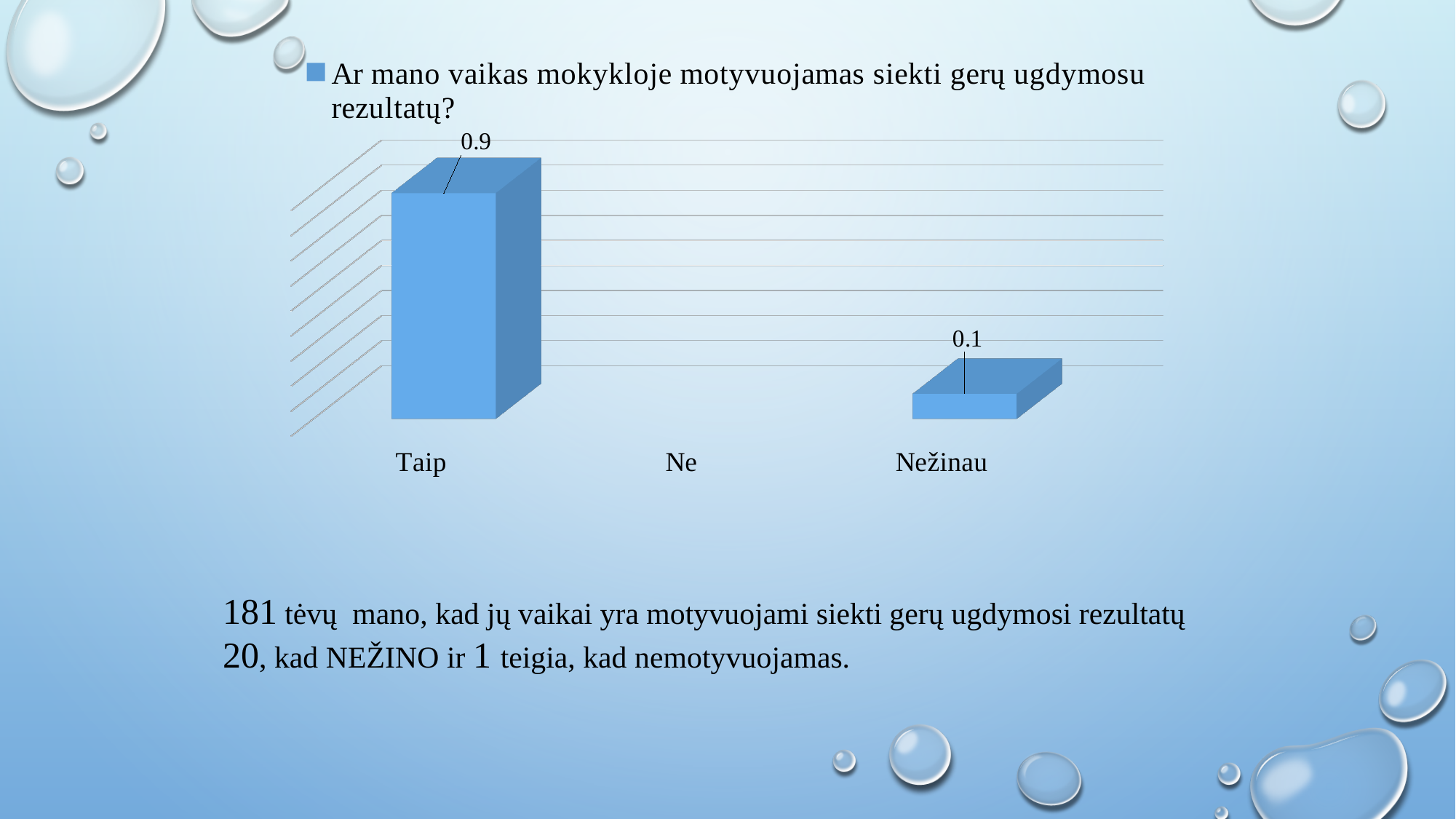
What is the value for Nežinau? 0.1 What is the difference between the values for Taip and Nežinau? 0.8 Which is larger, the value for Taip or the value for Nežinau? Taip What kind of chart is shown on the slide? Bar chart How many categories are shown on the x axis? 3 What is the value for Taip? 0.9 Which category has the highest value? Taip What colour are the bars in the chart? Blue